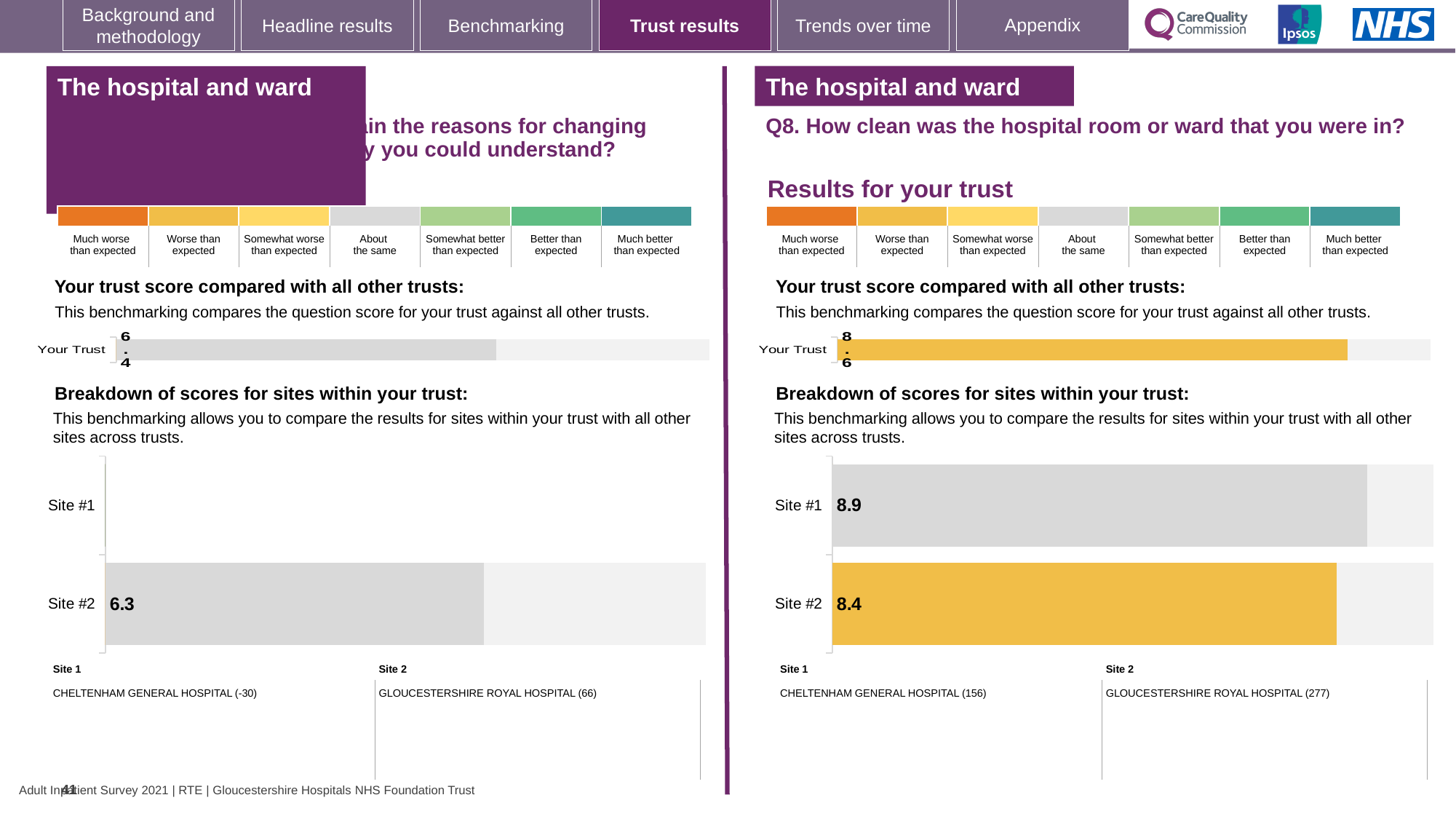
On the right-hand chart for Q8 (how clean was the hospital room or ward), what is the trust score shown for 'Your Trust'? 8.6 On the right-hand Q8 breakdown of scores for sites, which site has the higher score? Site #1 On the right-hand Q8 breakdown of scores for sites, what is the score for Site #1? 8.9 On the right-hand Q8 breakdown of scores for sites, what is the difference between the Site #1 and Site #2 scores? 0.5 Is the 'Your Trust' score on the right-hand Q8 chart larger or smaller than the 'Your Trust' score on the left-hand chart? Larger On the left-hand chart, what is the trust score shown for 'Your Trust'? 6.4 On the right-hand Q8 chart, what colour is the bar for Site #2? Yellow On the left-hand breakdown of scores for sites, what is the score for Site #2? 6.3 On the right-hand Q8 chart, which hospital is Site 2? Gloucestershire Royal Hospital On the left-hand breakdown of scores for sites, how many sites are listed? 2 What kind of chart is used for the breakdown of scores for sites on the right-hand side? Bar chart On the right-hand Q8 breakdown of scores for sites, what is the score for Site #2? 8.4